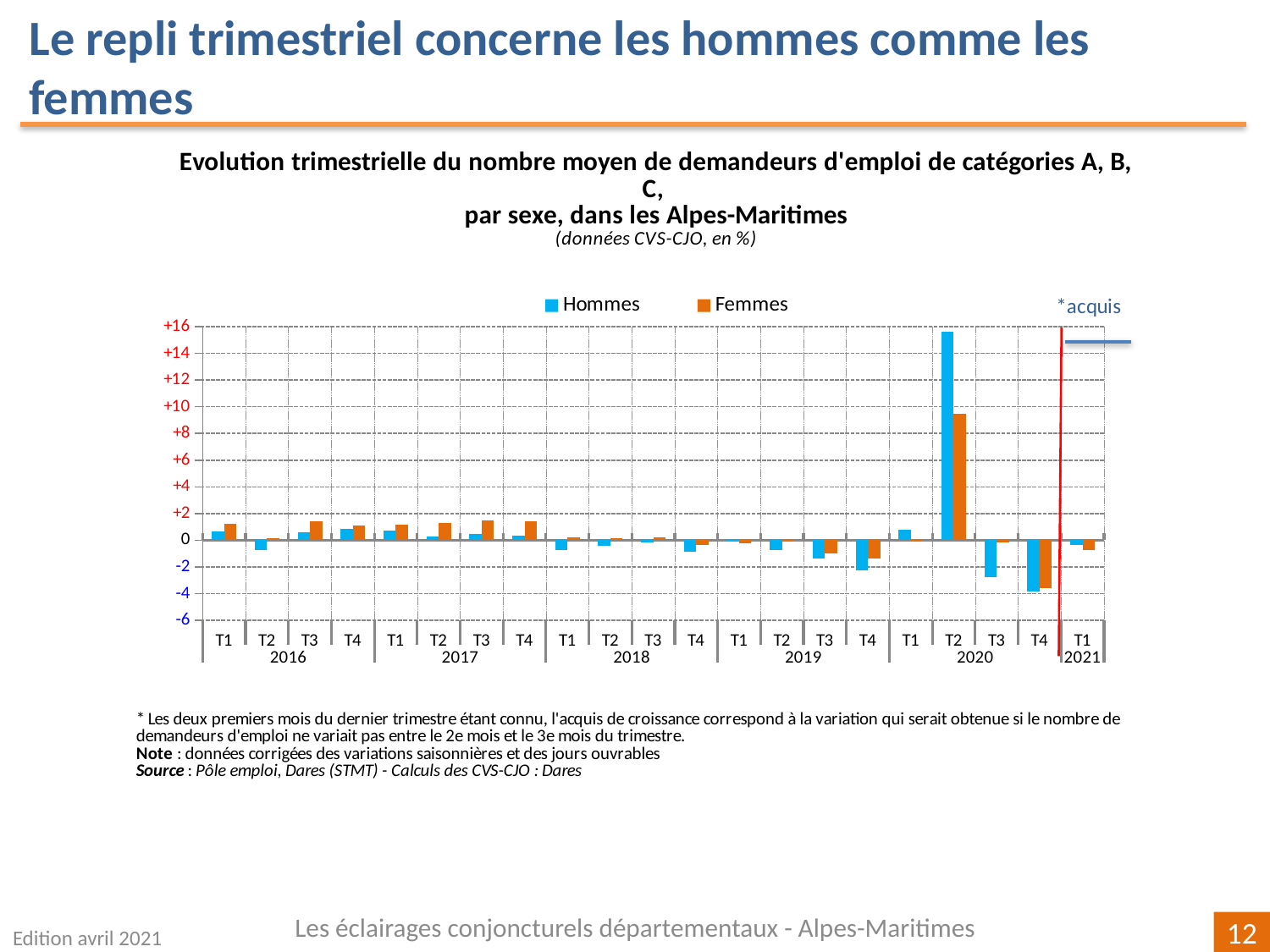
What kind of chart is shown on the slide? bar chart What are the two series named in the legend? Hommes and Femmes In which quarter is the Femmes value lowest? T4 2020 In T2 2020, which series has the larger value, Hommes or Femmes? Hommes How many quarters are plotted along the x axis? 21 Is the Hommes value for T2 2020 greater or less than +14? greater In which quarter is the Femmes value highest? T2 2020 In which quarter is the Hommes value lowest? T4 2020 Is the Femmes value for T2 2020 greater or less than +8? greater Is the Hommes value for T4 2020 greater or less than -2? less In which quarter is the Hommes value highest? T2 2020 How many series does the legend list? 2